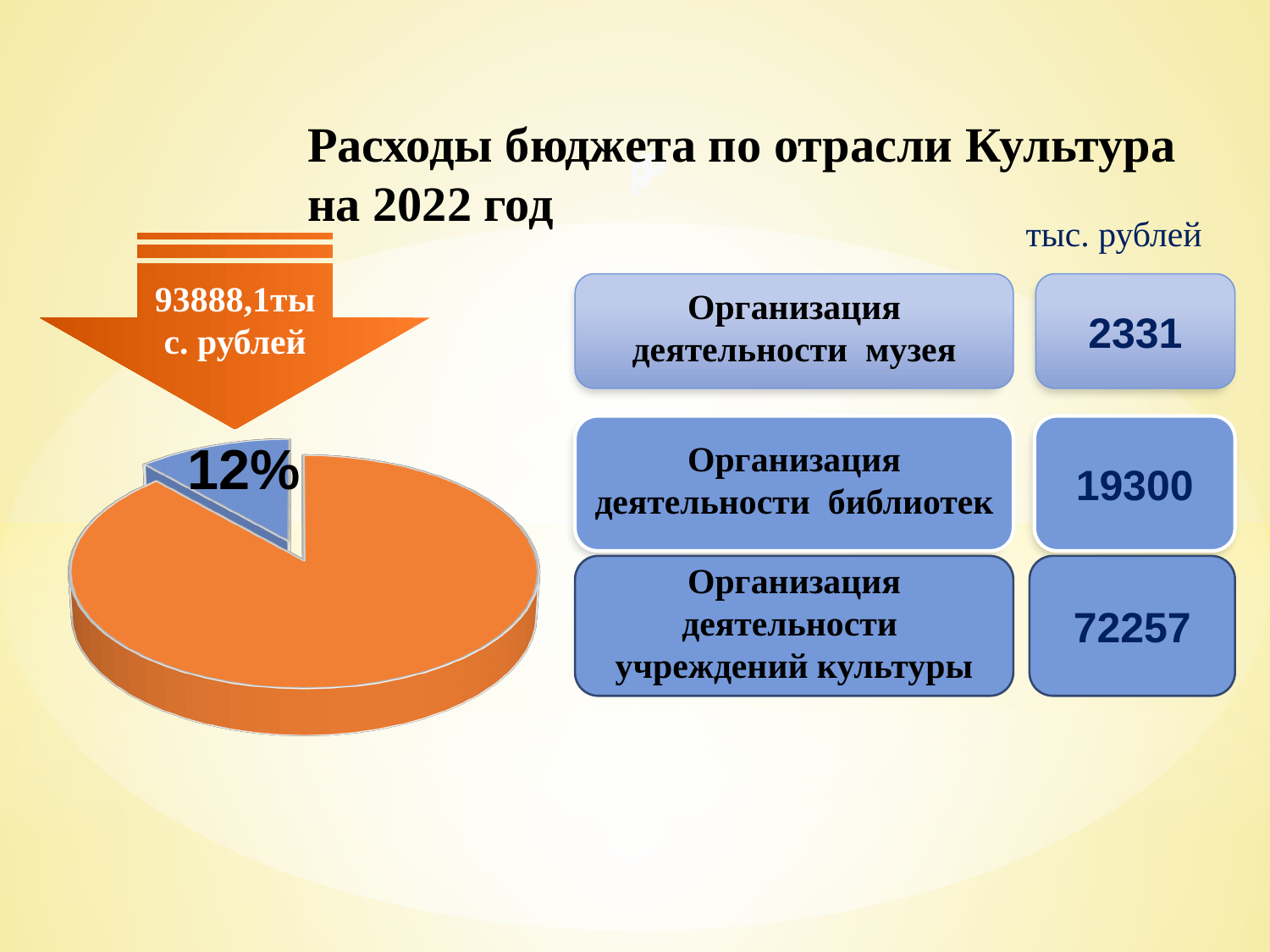
What percentage is printed on the blue slice of the pie chart? 12% What kind of chart is shown on the slide? pie chart Which slice of the pie chart is the smallest, the orange one or the blue one? the blue one Is the blue slice of the pie chart more or less than half of the pie? less How many slices does the pie chart have? 2 Which slice of the pie chart is the largest, the orange one or the blue one? the orange one Is the orange slice of the pie chart more or less than half of the pie? more What is the title of the slide containing the pie chart? Расходы бюджета по отрасли Культура на 2022 год What colour is the slice of the pie chart labelled 12%? blue